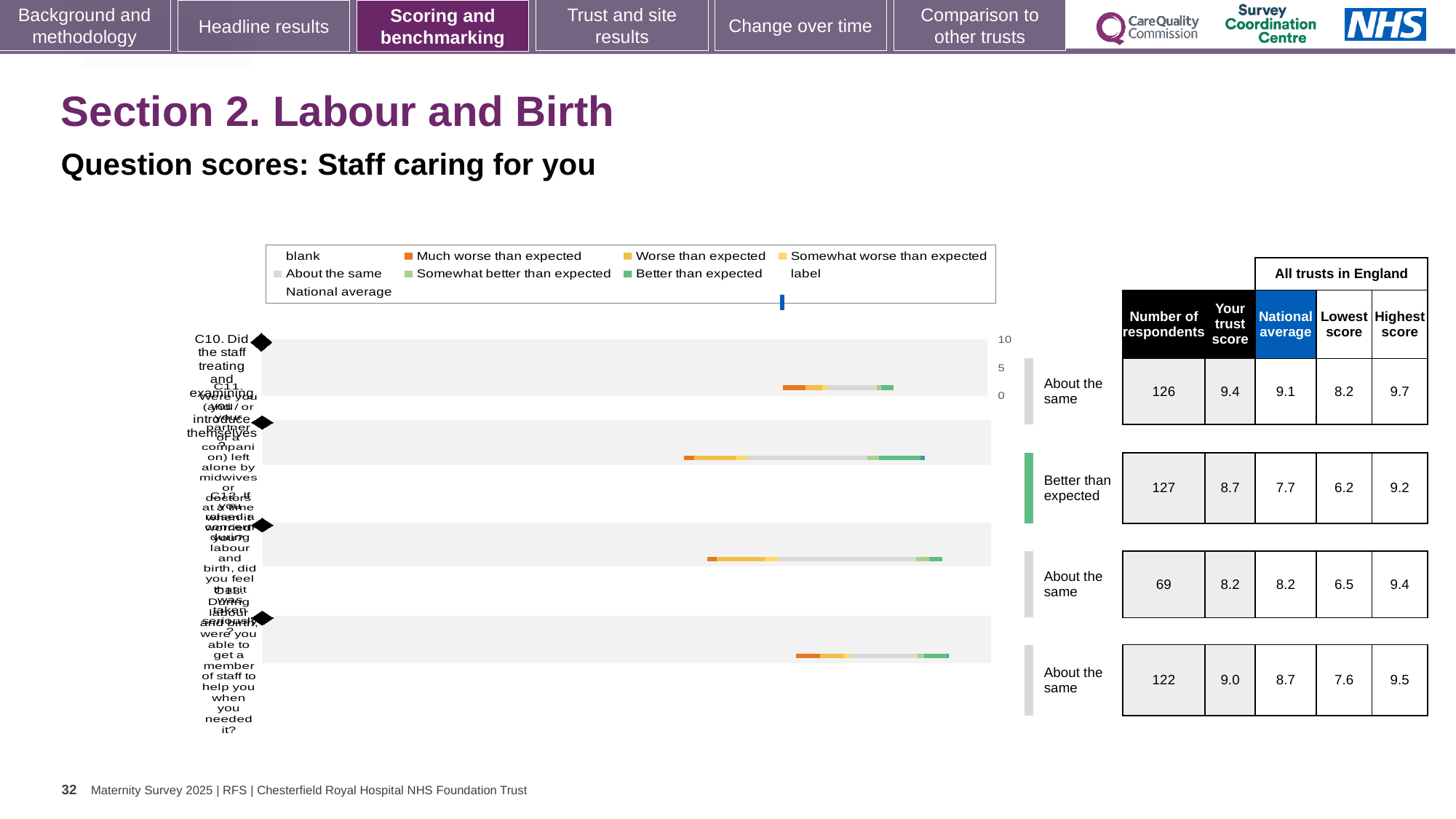
How many questions (C10 to C13) are plotted on the chart? 4 What is the highest score across all trusts in England for question C13? 9.5 Which question is rated 'Better than expected'? C11 For question C13, which is larger: the trust score or the national average? the trust score What is the number of respondents for question C10? 126 What is the trust score for question C11? 8.7 Which question has the lowest number of respondents? C12 Which question has the highest trust score? C10 What is the national average for question C12? 8.2 By how much does the trust score for C11 exceed the national average for C11? 1.0 What kind of chart is shown on the slide? bar chart What is the lowest score across all trusts in England for question C10? 8.2